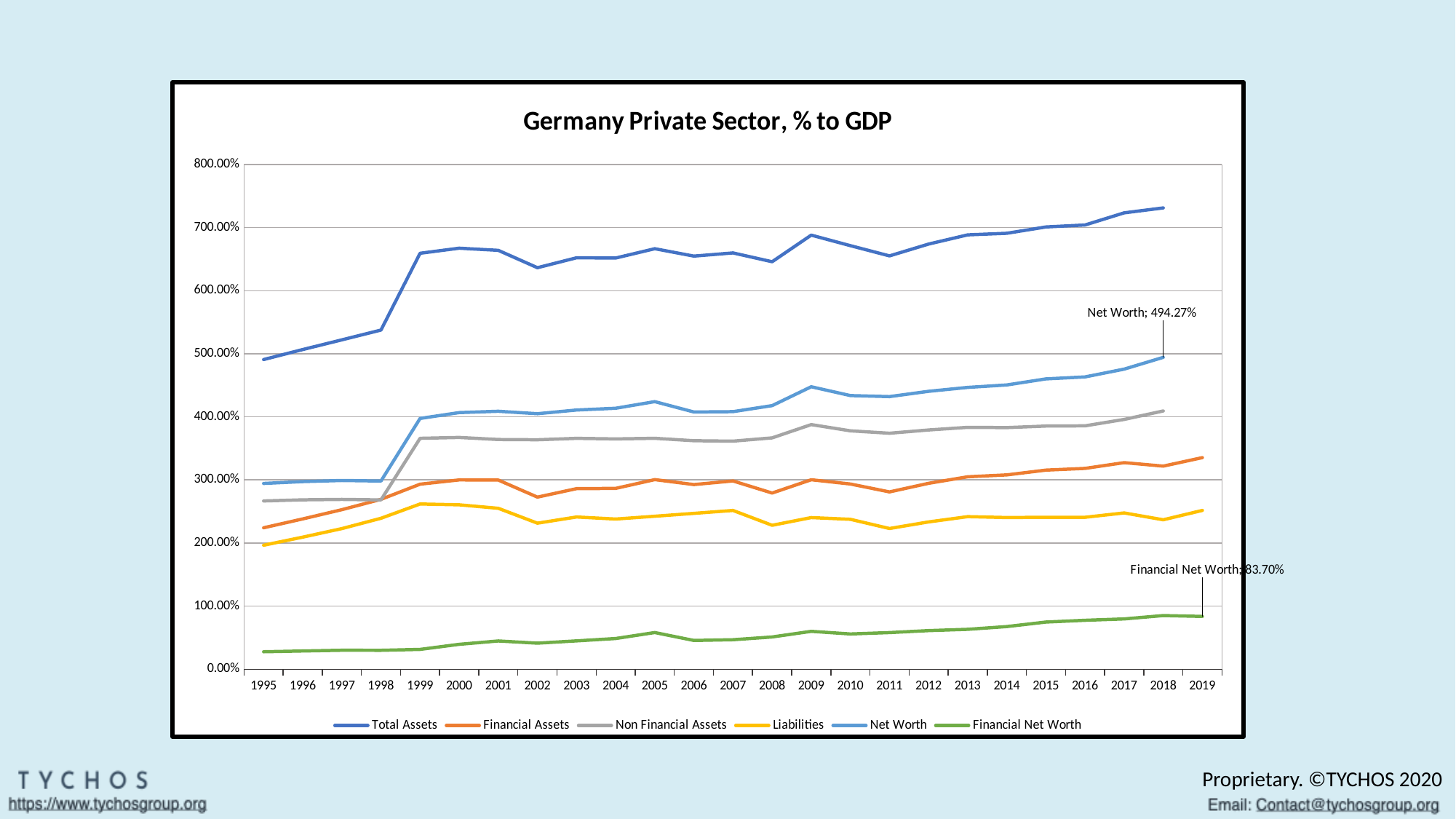
Which series has the lowest values across the chart? Financial Net Worth In 2010, which is larger: Net Worth or Non Financial Assets? Net Worth What kind of chart is shown on the slide? line chart What is the title of the chart? Germany Private Sector, % to GDP How many series does the legend list? 6 What value is shown by the data label on the Financial Net Worth line? 83.70% What value is shown by the data label on the Net Worth line? 494.27% Which series has the highest values across the chart? Total Assets How many years are shown on the x axis? 25 Does the Total Assets line generally rise or fall from 1995 to 2018? rise Is the value for Total Assets in 1995 greater or less than 500.00%? less Is the value for Total Assets in 2018 greater or less than 700.00%? greater